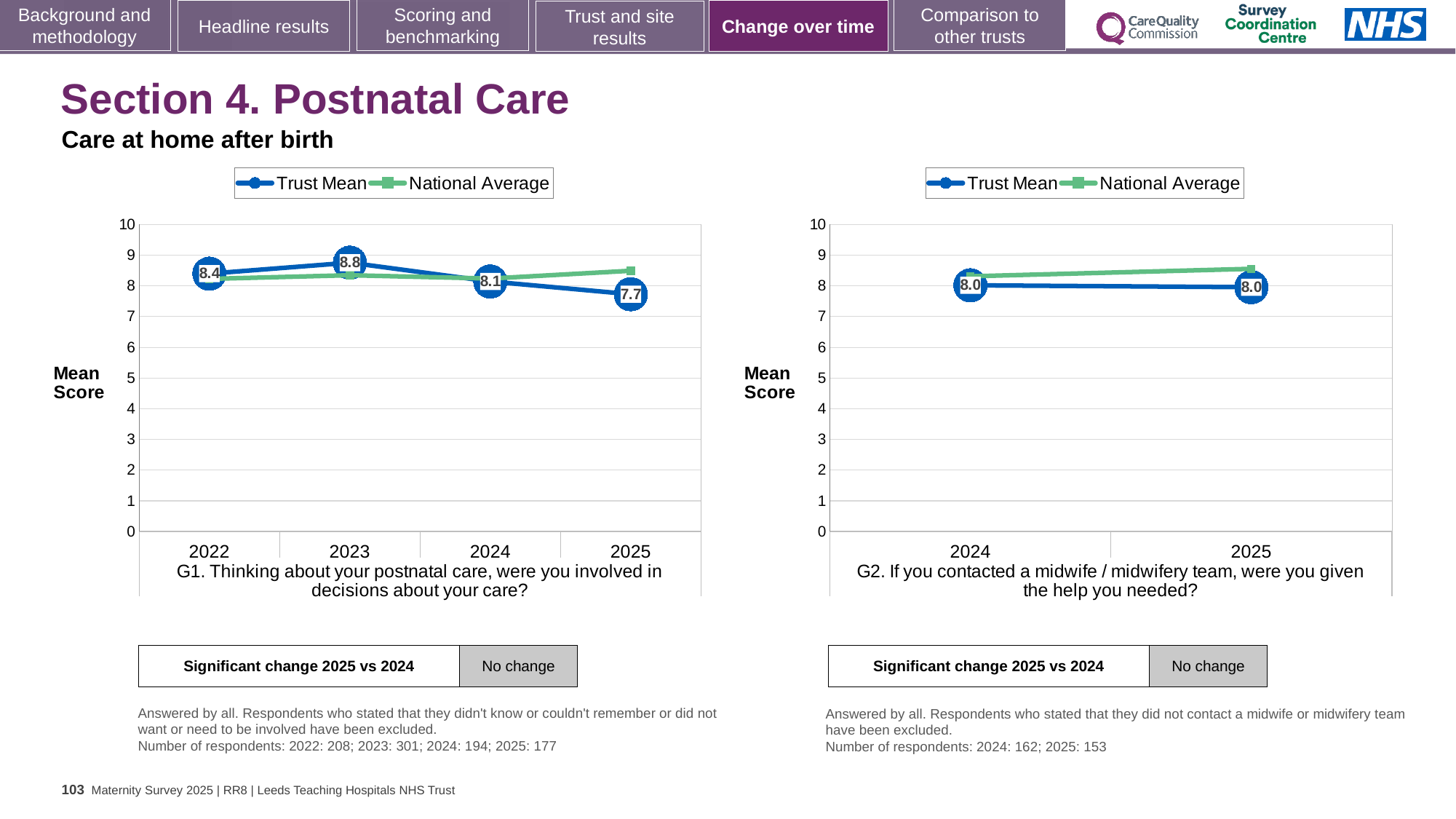
On the G1 chart (left), is the Trust Mean higher in 2022 or in 2024? 2022 On the G2 chart (right), how many series does the legend list? 2 On the G1 chart (left), which year has the highest Trust Mean? 2023 On the G1 chart (left), does the Trust Mean rise or fall from 2023 to 2025? fall On the G1 chart (left), what is the Trust Mean for 2025? 7.7 On the G1 chart (left), what is the difference between the Trust Mean in 2023 and in 2025? 1.1 On the G1 chart (left), which year has the lowest Trust Mean? 2025 On the G1 chart (left), what is the Trust Mean for 2023? 8.8 What kind of chart is the G2 chart (right)? line chart On the G1 chart (left), how many years are shown on the x axis? 4 On the G1 chart (left), is the National Average for 2025 greater or less than 8? greater On the G2 chart (right), what is the Trust Mean for 2025? 8.0